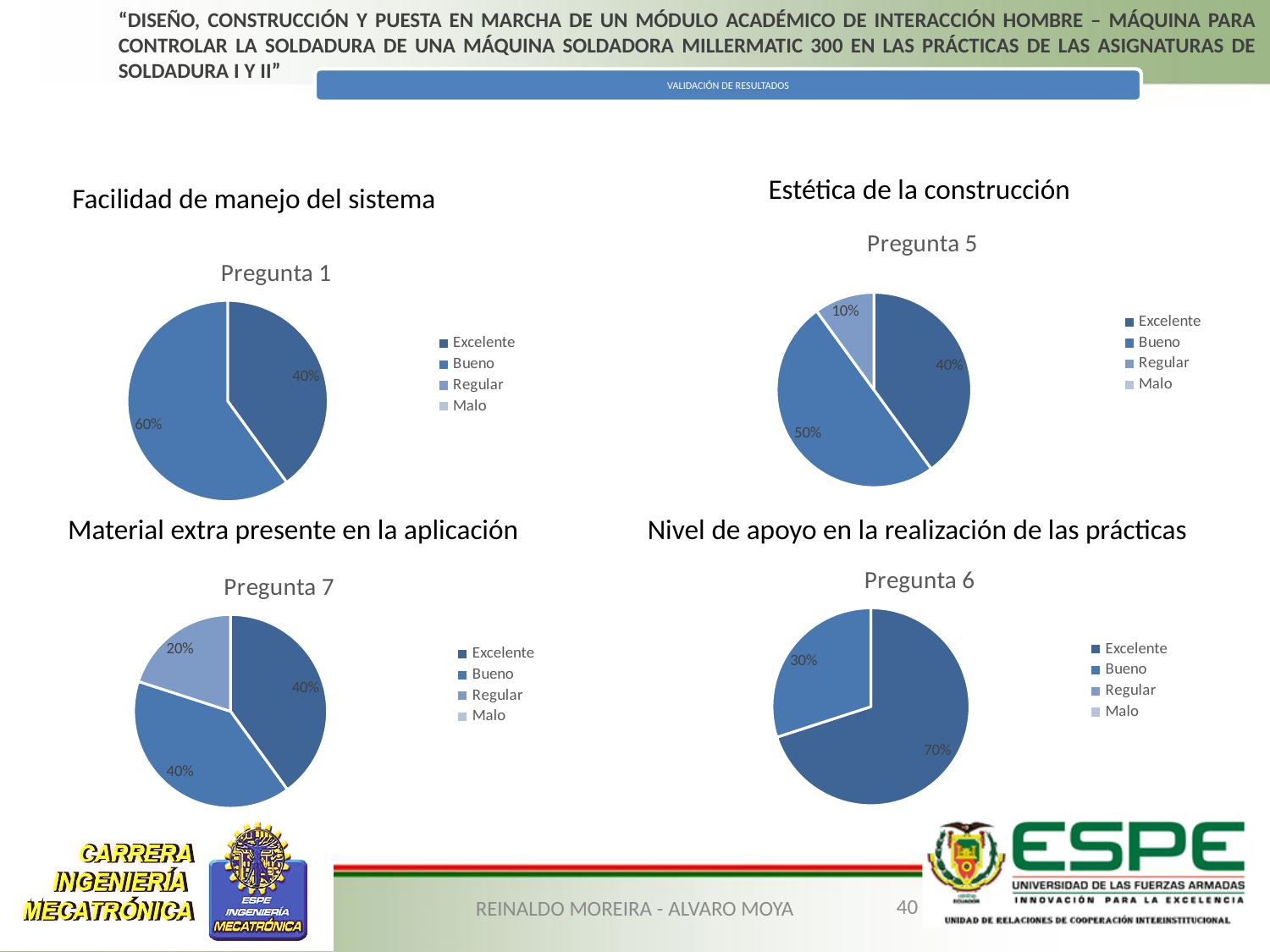
What type of chart is the Pregunta 7 chart? Pie chart In the Pregunta 7 chart, which category has the smallest slice? Regular In the Pregunta 5 chart, what percentage is shown for the Regular slice? 10% In the Pregunta 6 chart, what percentage is shown for Excelente? 70% In the Pregunta 5 chart, what is the difference between the Bueno and Excelente shares? 10% In the Pregunta 7 chart, what percentage is shown for the Regular slice? 20% In the Pregunta 1 chart, what share of the pie is labelled Bueno? 60% In the Pregunta 5 chart, which category has the largest slice? Bueno In the Pregunta 6 chart, what is the difference between the Excelente and Bueno shares? 40% In the Pregunta 6 chart, which is larger, the Excelente slice or the Bueno slice? Excelente In the Pregunta 1 chart, what share of the pie is labelled Excelente? 40% How many entries does the legend of the Pregunta 1 chart list? 4